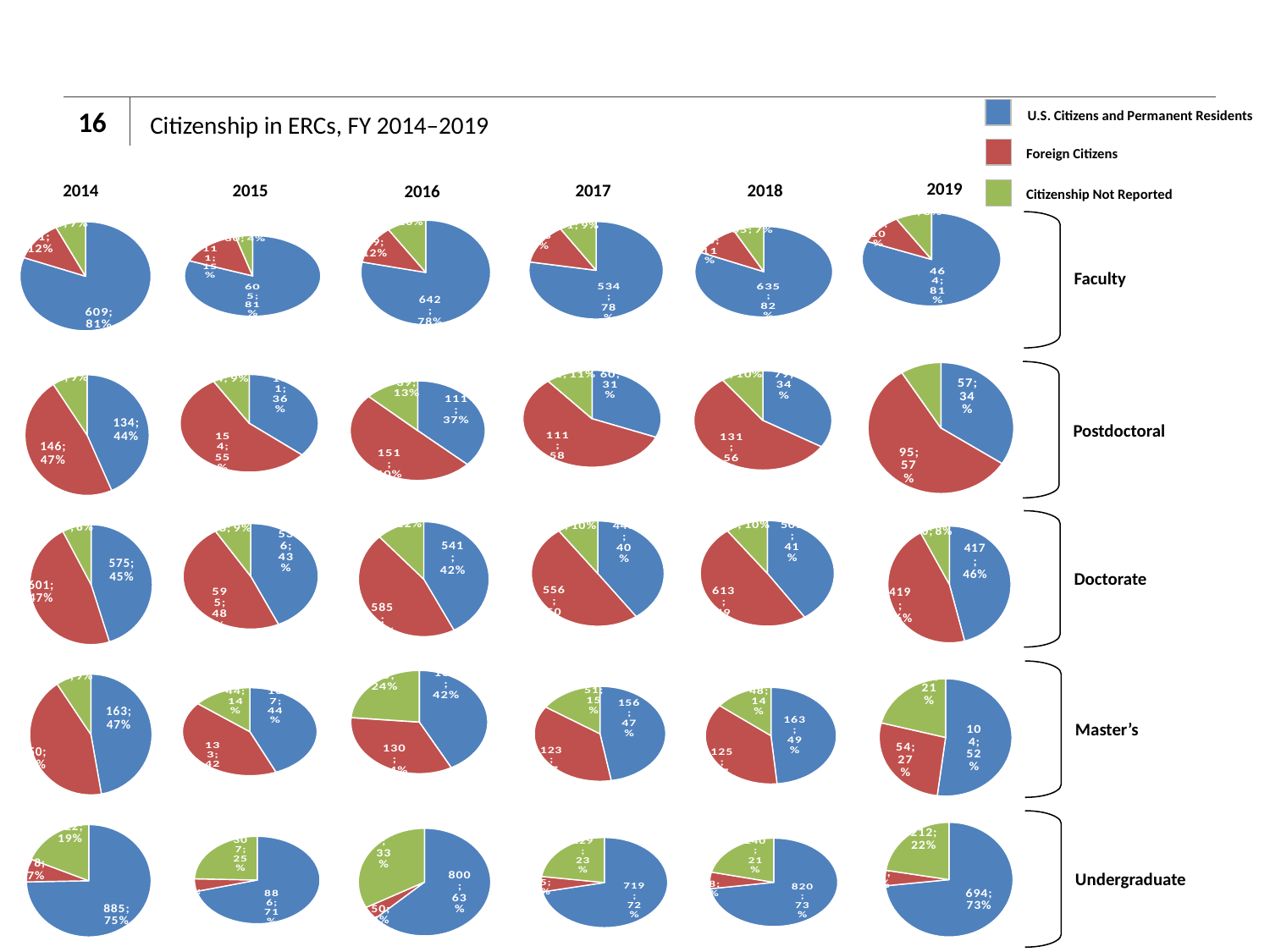
In the Postdoctoral 2019 pie chart, which is larger, U.S. Citizens and Permanent Residents or Foreign Citizens? Foreign Citizens In the Undergraduate 2019 pie chart, what is the value for Citizenship Not Reported? 212 In the Postdoctoral 2014 pie chart, what is the value for Foreign Citizens? 146 In the Faculty 2018 pie chart, what percentage of the pie is U.S. Citizens and Permanent Residents? 82% In the Doctorate 2019 pie chart, what is the value for U.S. Citizens and Permanent Residents? 417 In the Faculty 2014 pie chart, what is the value and share for U.S. Citizens and Permanent Residents? 609; 81% In the Postdoctoral 2016 pie chart, what share of the pie is Foreign Citizens? 50% In the Undergraduate 2016 pie chart, what share of the pie is U.S. Citizens and Permanent Residents? 63% What kind of charts are shown on the slide? Pie charts In the Master's 2019 pie chart, what is the value and share for Foreign Citizens? 54; 27% In the Doctorate 2014 pie chart, what is the difference between the Foreign Citizens value and the U.S. Citizens and Permanent Residents value? 26 How many series does the legend list? 3